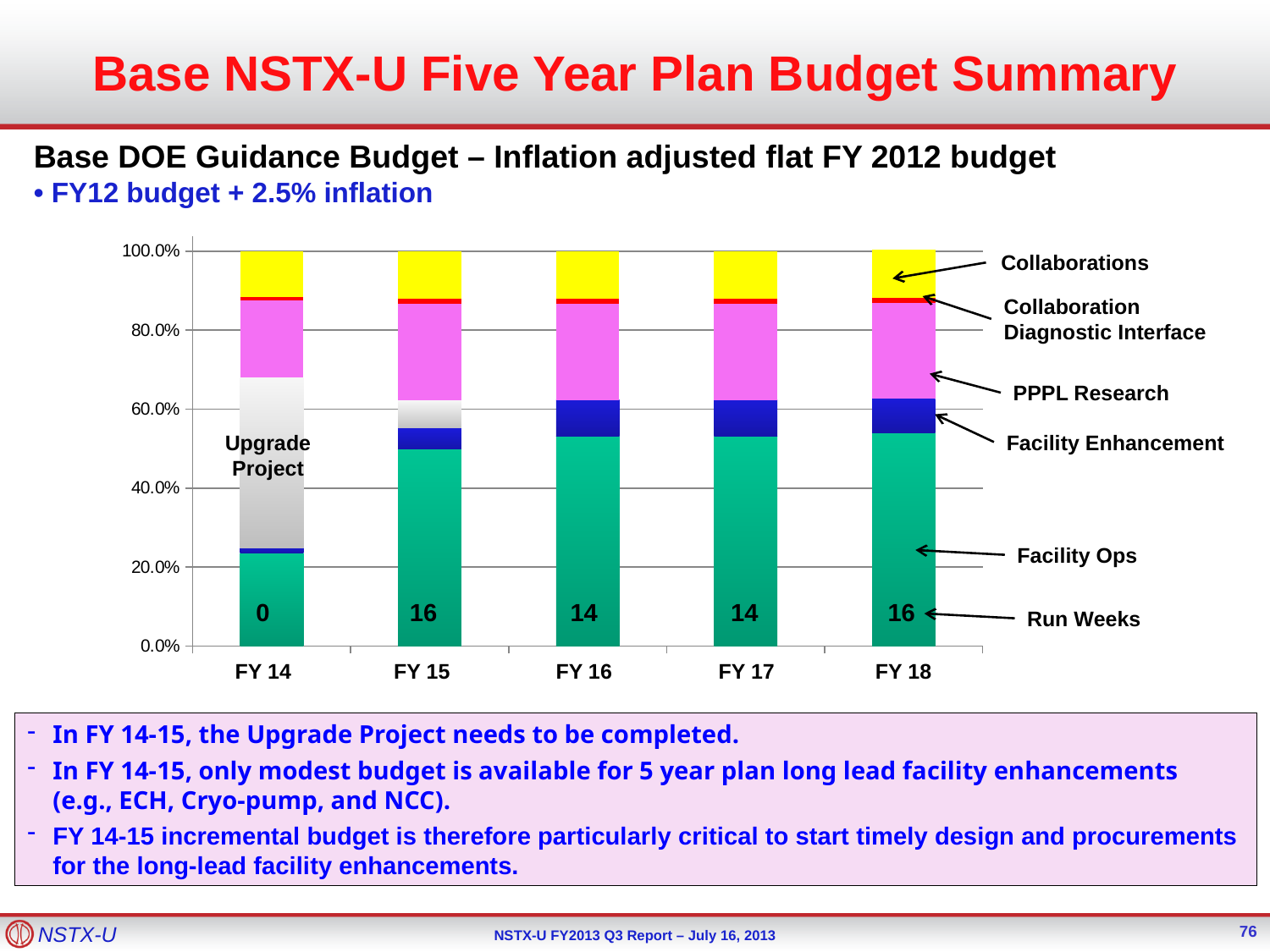
How many run weeks are labeled for FY 15? 16 Does the Facility Ops share rise or fall from FY 14 to FY 18? rise Is the Facility Ops share for FY 18 greater or less than 40.0%? greater How many run weeks are labeled for FY 17? 14 Which fiscal year has the lowest number of run weeks? FY 14 How many run weeks are labeled for FY 14? 0 What kind of chart is shown on the slide? Stacked bar chart What is the difference in run weeks between FY 18 and FY 16? 2 In which fiscal years does the Upgrade Project segment appear in the chart? FY 14 and FY 15 Is the Facility Ops share for FY 14 greater or less than 40.0%? less Which has more run weeks, FY 15 or FY 17? FY 15 How many fiscal years are shown on the x axis of the chart? 5